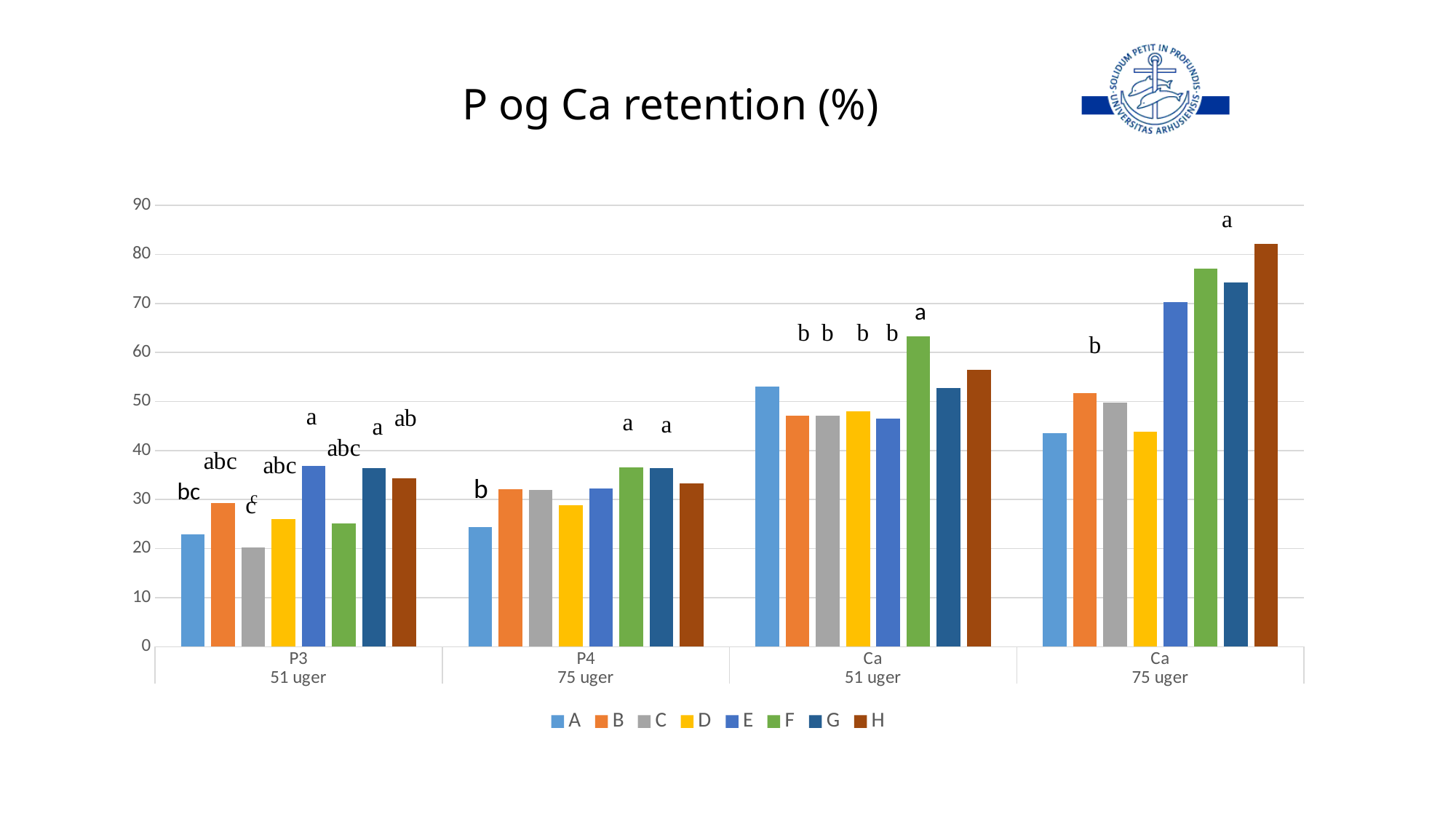
Which series has the lowest bar in the P4 75 uger group? A What kind of chart is shown on the slide? bar chart Which series has the highest bar in the Ca 51 uger group? F Which series has the lowest bar in the P3 51 uger group? C Which series has the highest bar in the Ca 75 uger group? H Which is larger for series F: the Ca 51 uger bar or the Ca 75 uger bar? Ca 75 uger Is the value for C in the P3 51 uger group greater or less than 30? less How many category groups are shown on the x axis? 4 How many series does the legend list? 8 Is the value for H in the Ca 75 uger group greater or less than 70? greater What is the title of the chart? P og Ca retention (%) Is the value for F in the Ca 51 uger group greater or less than 60? greater